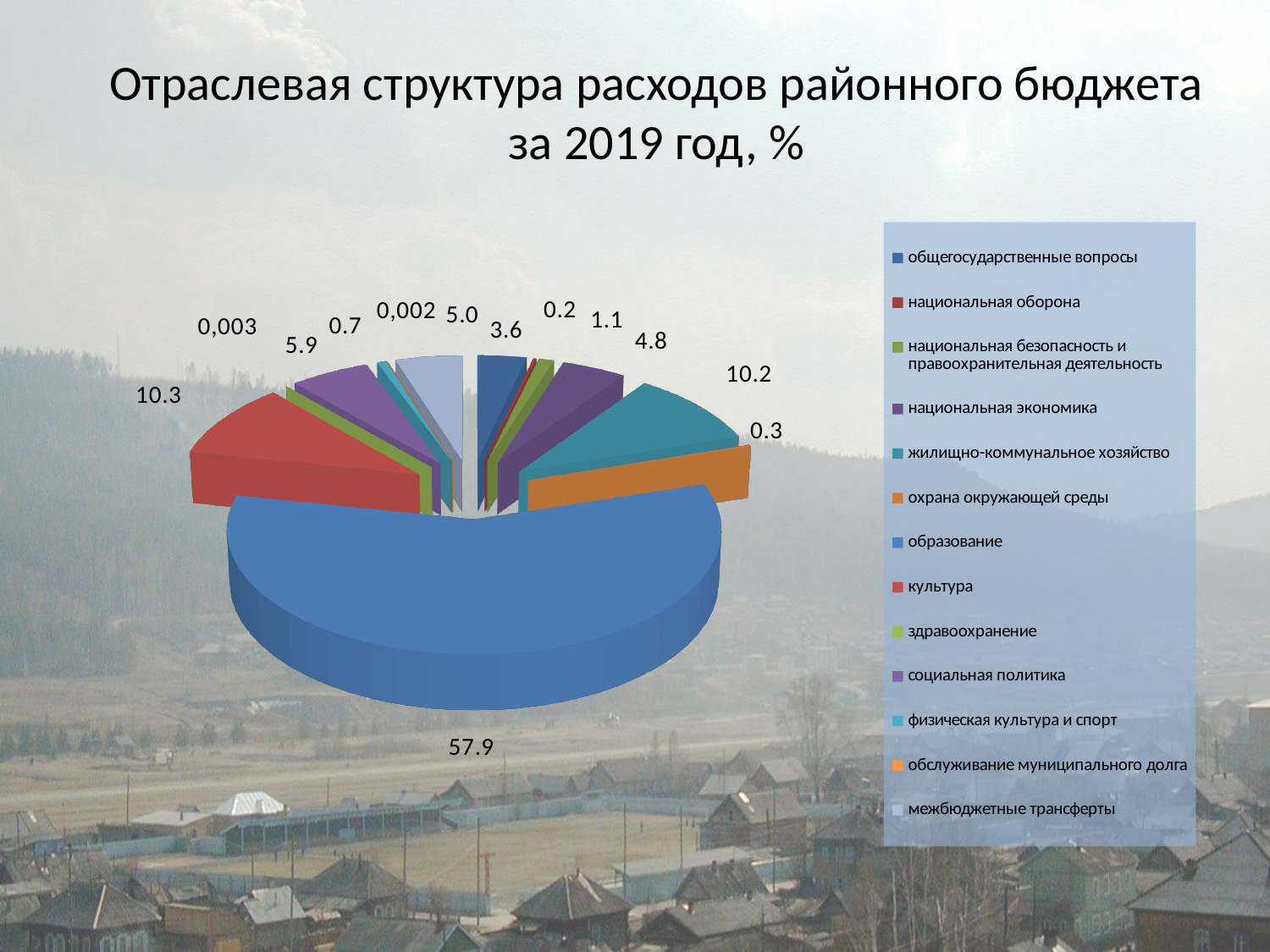
Which is larger, the value for образование or the value for национальная экономика? образование What is the value shown for образование? 57.9 What is the value shown for жилищно-коммунальное хозяйство? 10.2 What is the value shown for общегосударственные вопросы? 3.6 How many categories does the legend list? 13 What is the difference between the values for образование and культура? 47.6 Which category has the largest share of the pie? образование What is the value shown for культура? 10.3 What is the value shown for национальная экономика? 4.8 What is the smallest value printed on the chart? 0,002 What kind of chart is shown on the slide? pie chart What is the title of the chart? Отраслевая структура расходов районного бюджета за 2019 год, %